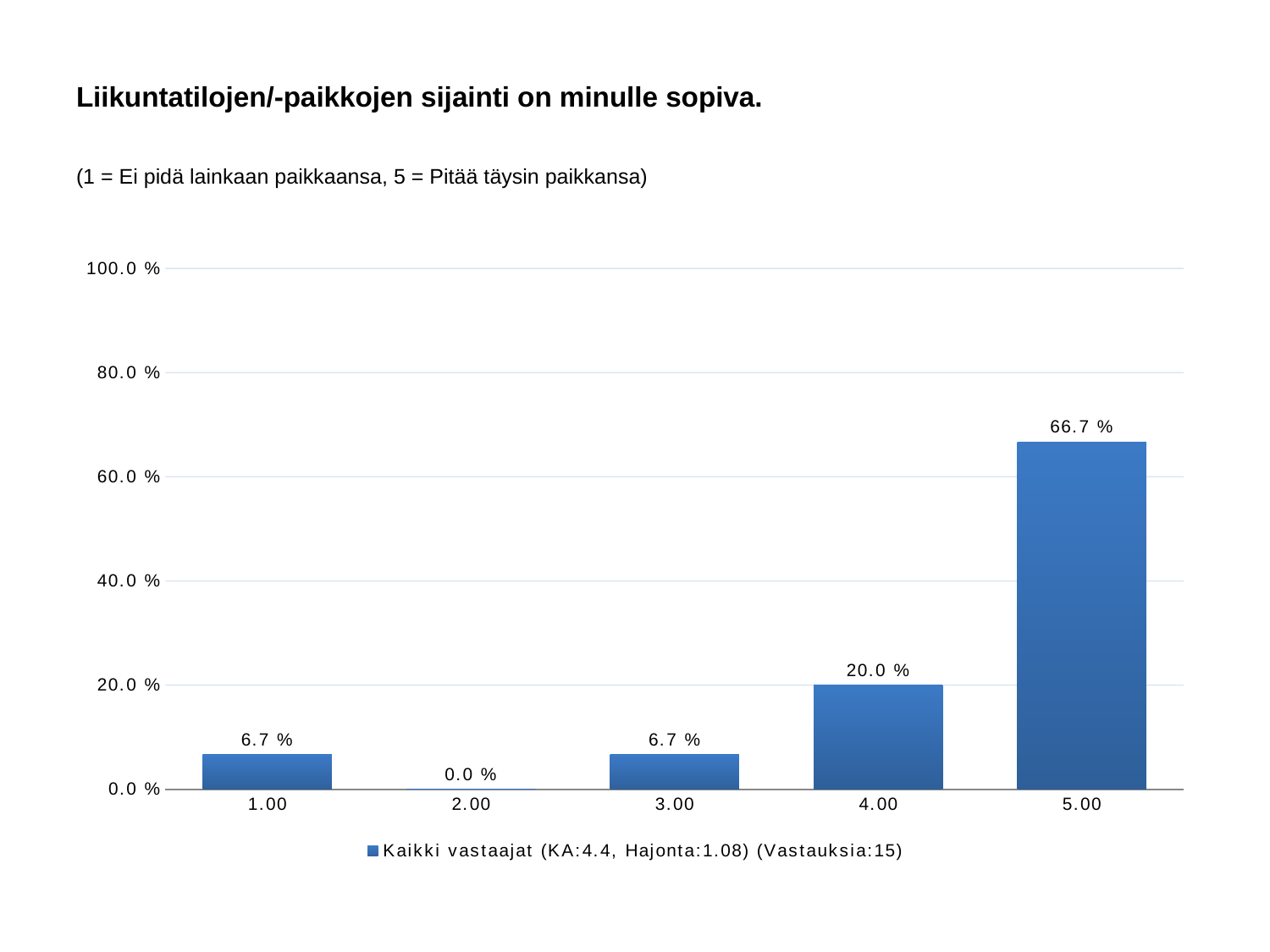
What kind of chart is shown? bar chart Is the value for 5.00 greater or less than 60.0 %? greater What is the value for category 2.00? 0.0 % How many categories are shown on the x axis? 5 What is the difference between the values for 5.00 and 4.00? 46.7 % What is the value for category 5.00? 66.7 % How many series does the legend list? 1 What is the value for category 4.00? 20.0 % What is the legend entry for the series? Kaikki vastaajat (KA:4.4, Hajonta:1.08) (Vastauksia:15) Which category has the lowest value? 2.00 Which category has the highest value? 5.00 Which is larger, the value for 4.00 or the value for 3.00? 4.00